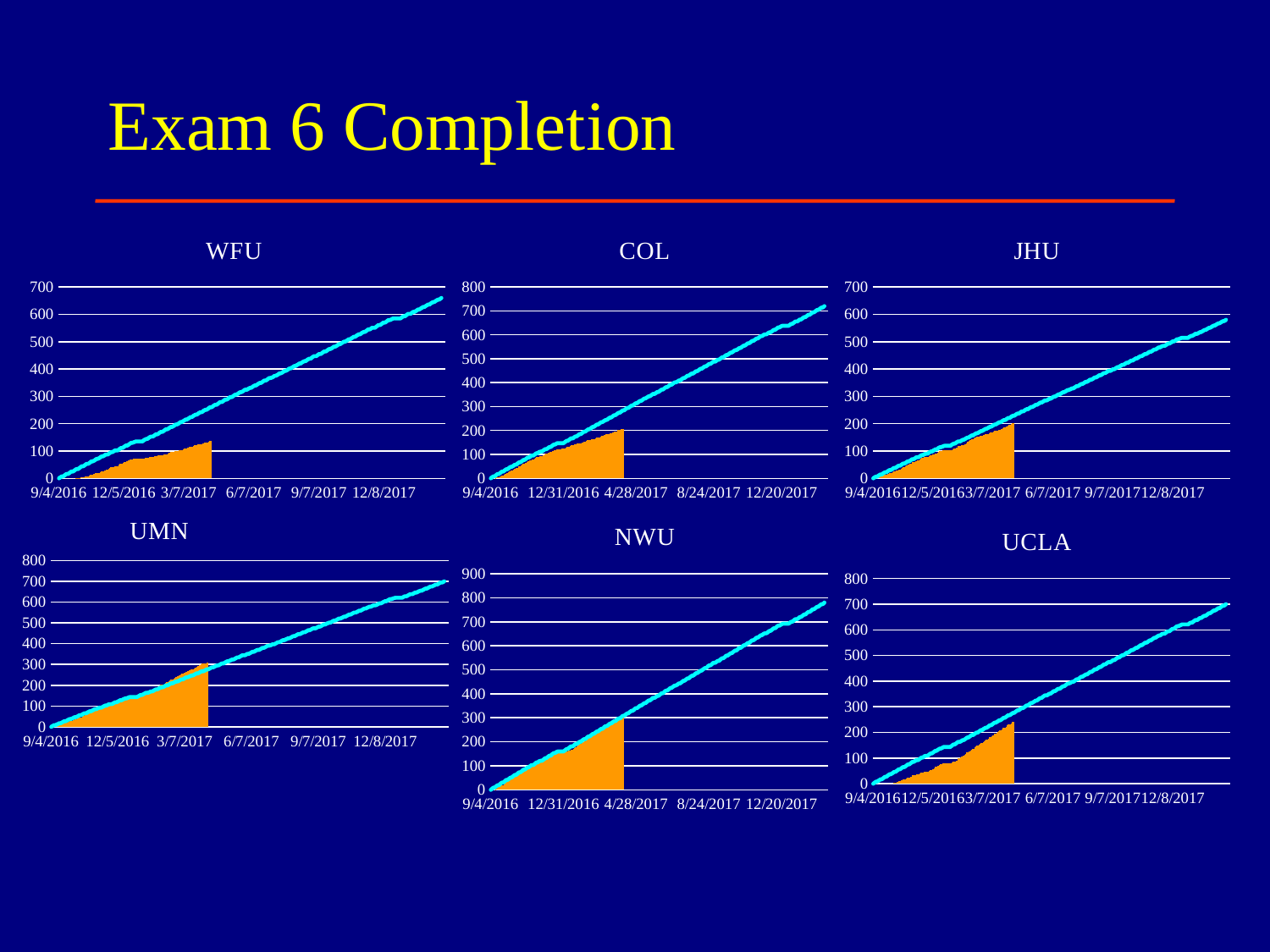
What kind of chart is the WFU chart? line chart In the JHU chart, do the values rise or fall along the x axis? rise What is the highest value shown on the y axis of the NWU chart? 900 How many charts are shown on the slide? 6 In the COL chart, is the final value of the line greater or less than 600? greater In the UMN chart, is the value of the line at 9/4/2016 greater or less than 100? less In the WFU chart, is the final value of the line greater or less than 600? greater What is the first date shown on the x axis of the UCLA chart? 9/4/2016 In the COL chart, do the values rise or fall over time along the x axis? rise